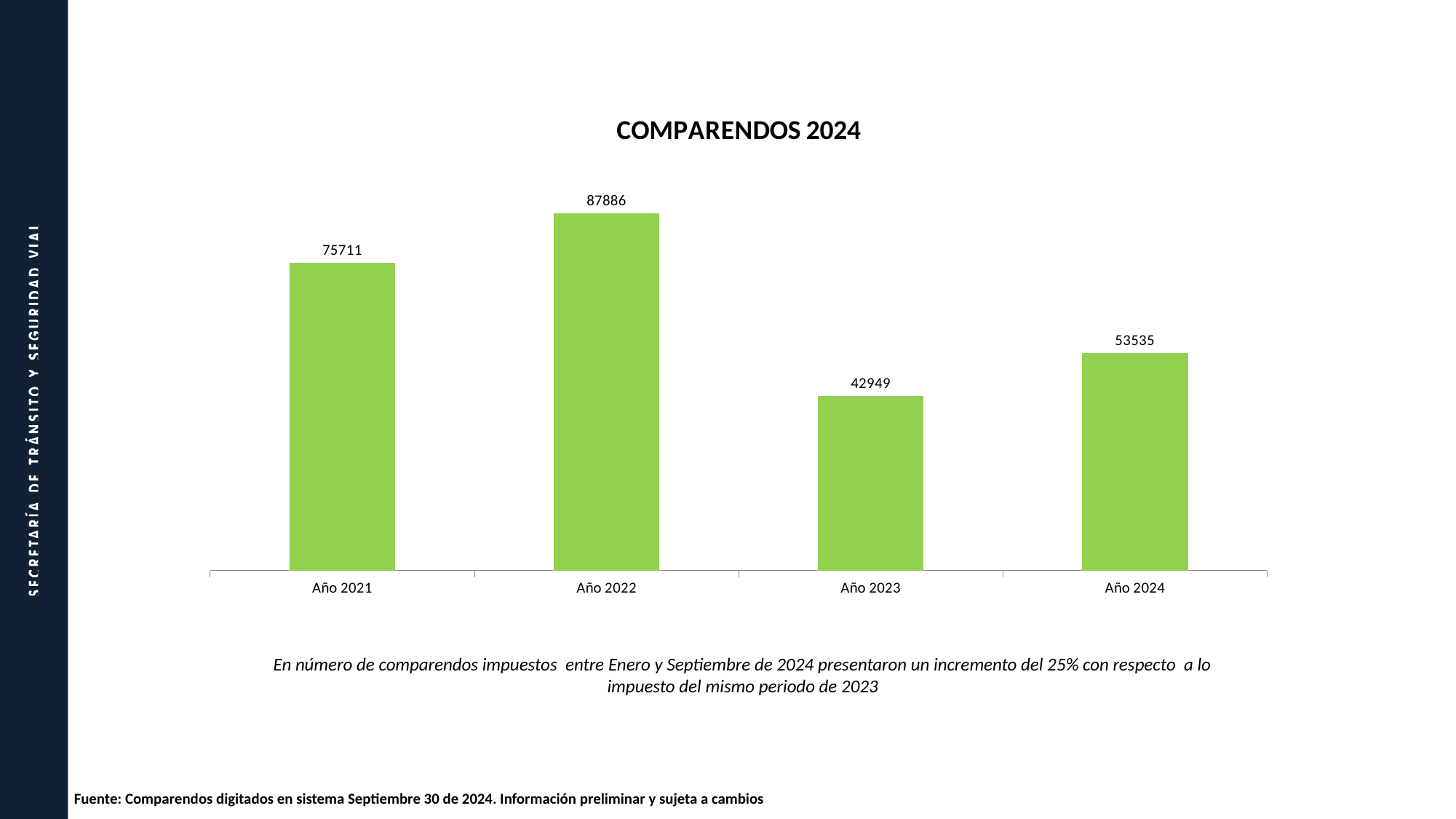
What is the value for Año 2022? 87886 What is the value for Año 2023? 42949 Which year has the lowest value? Año 2023 Which year has the highest value? Año 2022 What is the difference between the values for Año 2024 and Año 2023? 10586 What kind of chart is shown on the slide? Bar chart What is the value for Año 2021? 75711 What is the difference between the values for Año 2022 and Año 2021? 12175 How many years are shown on the chart? 4 What is the title of the chart? COMPARENDOS 2024 Which is larger, the value for Año 2021 or the value for Año 2024? Año 2021 What is the value for Año 2024? 53535